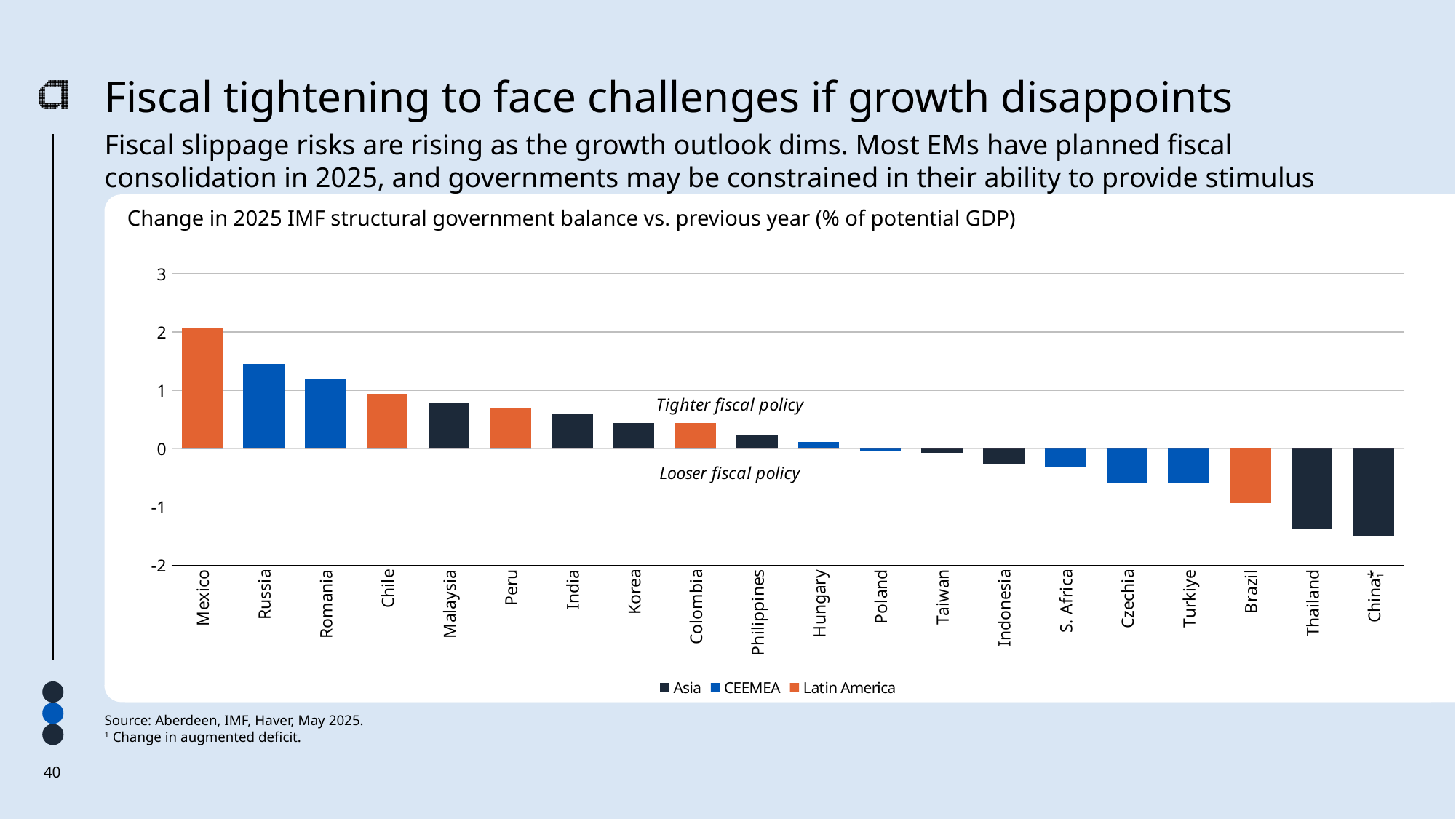
Which has the larger value, Russia or Romania? Russia Which colour represents Latin America in the legend? Orange Do the values rise or fall moving from left to right across the countries? Fall How many series does the legend list? 3 Is the value for Mexico greater or less than 1? greater Is the value for Romania greater or less than 1? greater Which country has the highest change in 2025 IMF structural government balance? Mexico Is the value for Russia greater or less than 2? less How many countries are plotted on the chart? 20 What kind of chart is shown on the slide? Bar chart